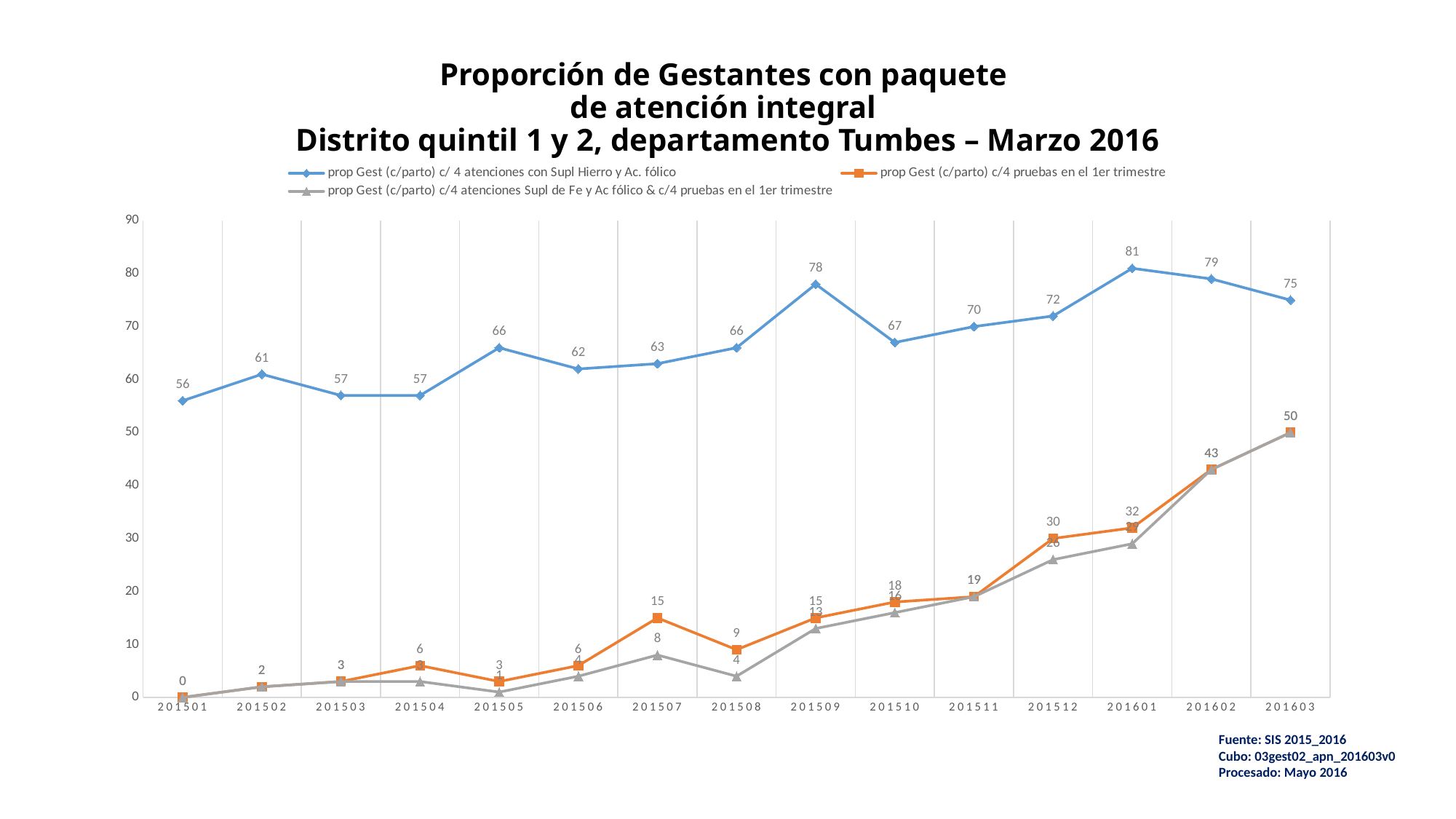
What is the value of the 'prop Gest (c/parto) c/ 4 atenciones con Supl Hierro y Ac. fólico' series at 201509? 78 What is the difference between the 'prop Gest (c/parto) c/ 4 atenciones con Supl Hierro y Ac. fólico' values at 201601 and 201501? 25 How many periods are shown on the x axis of the chart? 15 What kind of chart is shown on the slide? Line chart In which period does the 'prop Gest (c/parto) c/ 4 atenciones con Supl Hierro y Ac. fólico' series reach its highest value? 201601 What is the value of the 'prop Gest (c/parto) c/4 pruebas en el 1er trimestre' series at 201603? 50 Does the 'prop Gest (c/parto) c/4 pruebas en el 1er trimestre' series generally rise or fall from 201501 to 201603? Rise At 201507, which series is higher: 'prop Gest (c/parto) c/4 pruebas en el 1er trimestre' or 'prop Gest (c/parto) c/4 atenciones Supl de Fe y Ac fólico & c/4 pruebas en el 1er trimestre'? prop Gest (c/parto) c/4 pruebas en el 1er trimestre How many series does the legend list? 3 Is the value of the 'prop Gest (c/parto) c/4 pruebas en el 1er trimestre' series at 201602 greater or less than 40? greater What is the value of the 'prop Gest (c/parto) c/4 atenciones Supl de Fe y Ac fólico & c/4 pruebas en el 1er trimestre' series at 201509? 13 In which period does the 'prop Gest (c/parto) c/ 4 atenciones con Supl Hierro y Ac. fólico' series have its lowest value? 201501